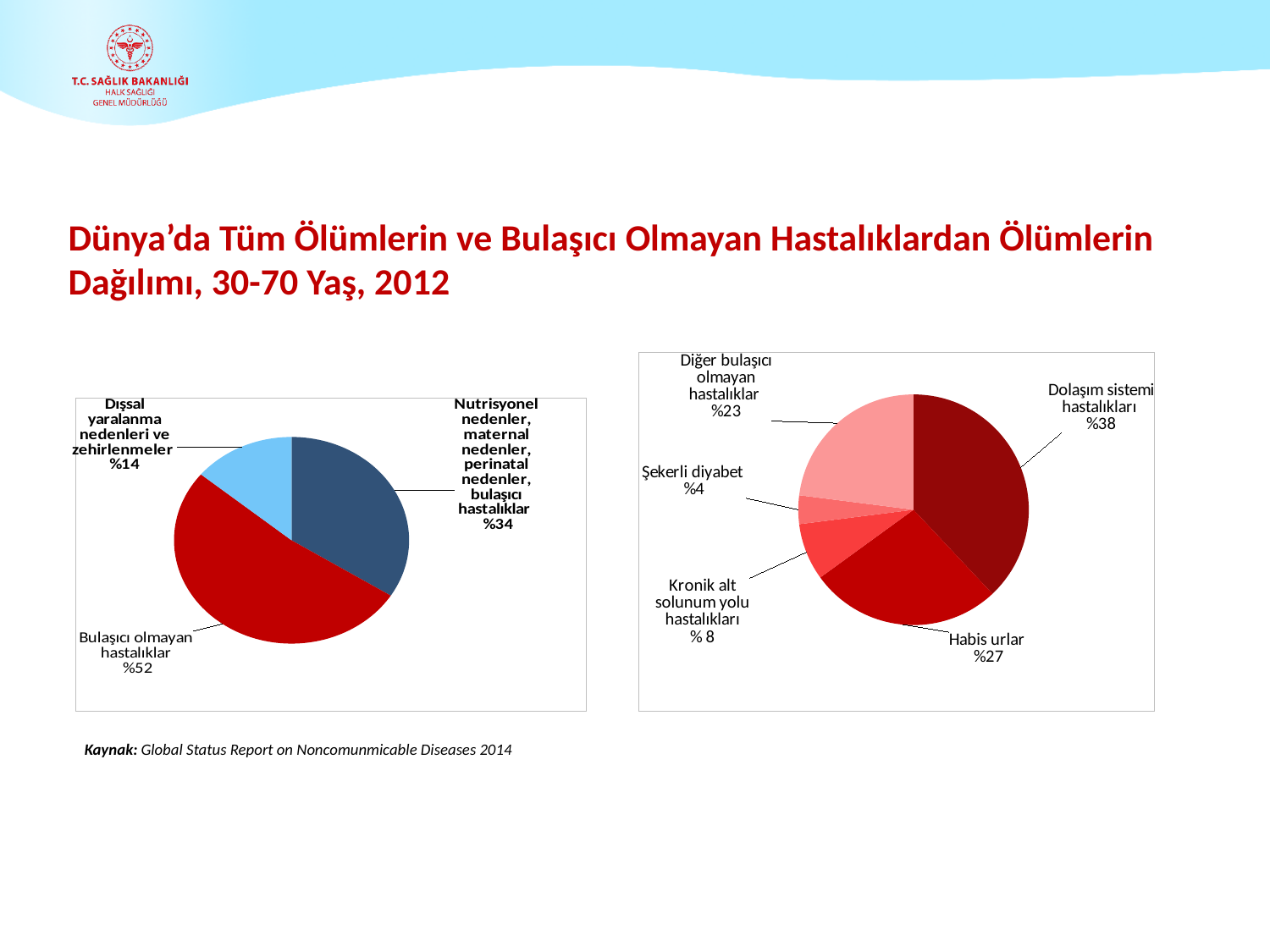
In the left pie chart, what share is labelled for Bulaşıcı olmayan hastalıklar? %52 In the right pie chart, which slice is the smallest? Şekerli diyabet In the right pie chart, what is the difference between the shares for Dolaşım sistemi hastalıkları and Habis urlar? 11 percentage points In the right pie chart, what share is labelled for Habis urlar? %27 In the right pie chart, what share is labelled for Şekerli diyabet? %4 How many slices does the right pie chart have? 5 What type of chart is the left chart on the slide? Pie chart In the left pie chart, which slice is the smallest? Dışsal yaralanma nedenleri ve zehirlenmeler In the right pie chart, what share is labelled for Dolaşım sistemi hastalıkları? %38 How many slices does the left pie chart have? 3 In the left pie chart, what share is labelled for Dışsal yaralanma nedenleri ve zehirlenmeler? %14 In the left pie chart, which slice is the largest? Bulaşıcı olmayan hastalıklar